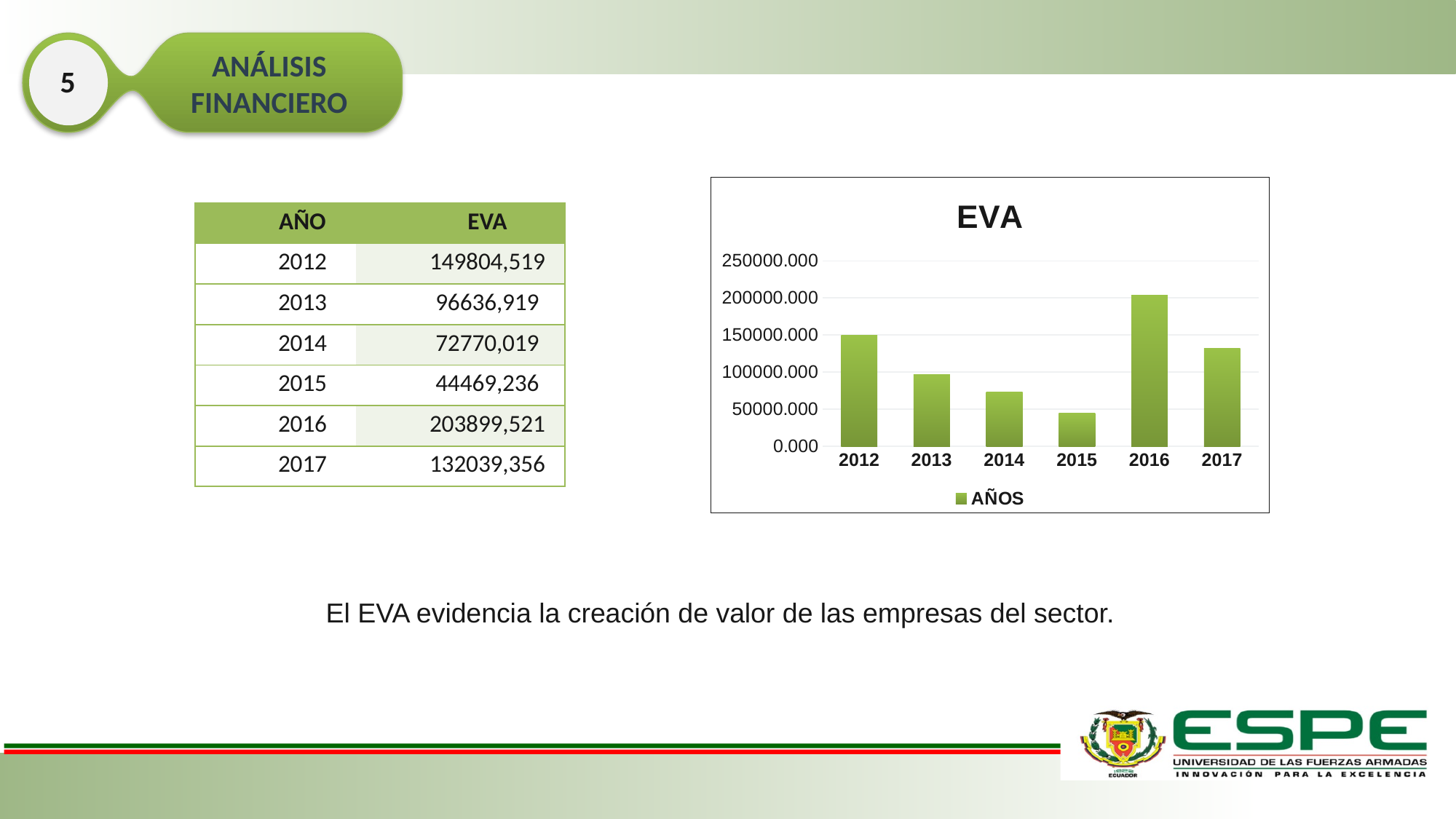
Which year has the highest EVA value? 2016 What type of chart is shown on the slide? bar chart Which year has the lowest EVA value? 2015 How many years are plotted on the x axis of the EVA chart? 6 Which year has a larger EVA value, 2012 or 2017? 2012 According to the slide, what is the EVA value for 2016? 203899,521 According to the slide, what is the EVA value for 2015? 44469,236 How many series does the legend of the EVA chart list? 1 Is the EVA value for 2015 greater or less than 50000.000? less What is the legend entry of the EVA chart? AÑOS What is the title of the chart? EVA Is the EVA value for 2017 greater or less than 100000.000? greater